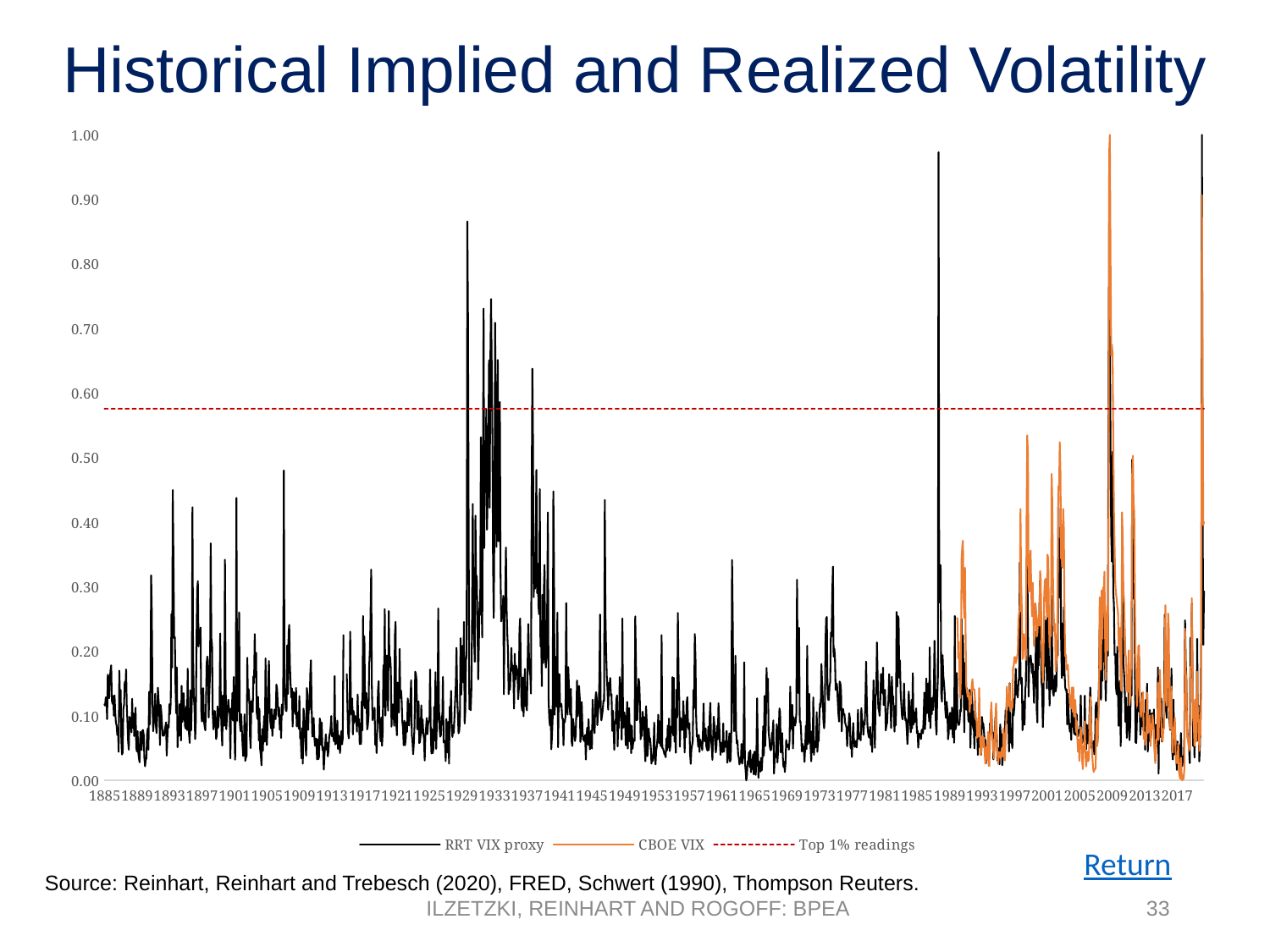
What is the last year label shown on the x axis? 2017 Is the highest peak of the CBOE VIX series around 2008 greater or less than 0.90? greater Is the level of the Top 1% readings line greater or less than 0.50? greater Is the peak of the RRT VIX proxy around 1929 greater or less than 0.80? greater What is the title of the chart? Historical Implied and Realized Volatility Which series is drawn as a red dashed horizontal line? Top 1% readings What is the highest value shown on the y axis? 1.00 What is the first year label shown on the x axis? 1885 What kind of chart is shown on the slide? line chart How many series does the legend list? 3